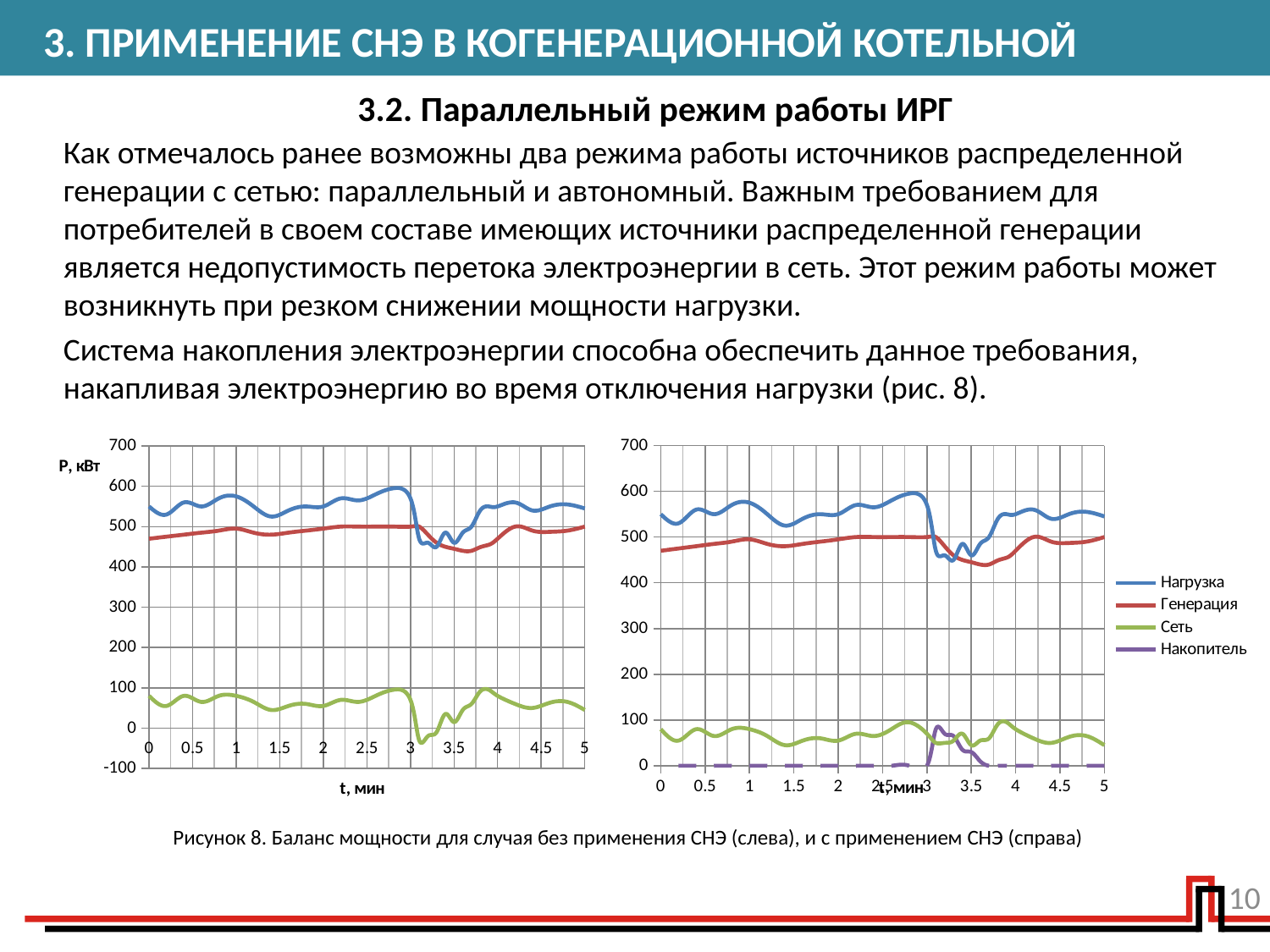
In the right chart, is the value of Нагрузка at t = 2.5 greater or less than 500? greater In the left chart, is the value of the blue (Нагрузка) line at t = 0 greater or less than 500? greater How many series does the legend of the right chart list? 4 In the left chart, is the value of the red (Генерация) line at t = 2.5 greater or less than 400? greater In the right chart, which is larger at t = 1: Нагрузка or Генерация? Нагрузка What are the legend entries of the right chart? Нагрузка, Генерация, Сеть, Накопитель What kind of chart is the left chart on the slide? line chart What is the y-axis label of the left chart? P, кВт In the right chart, which is larger at t = 2: Генерация or Сеть? Генерация